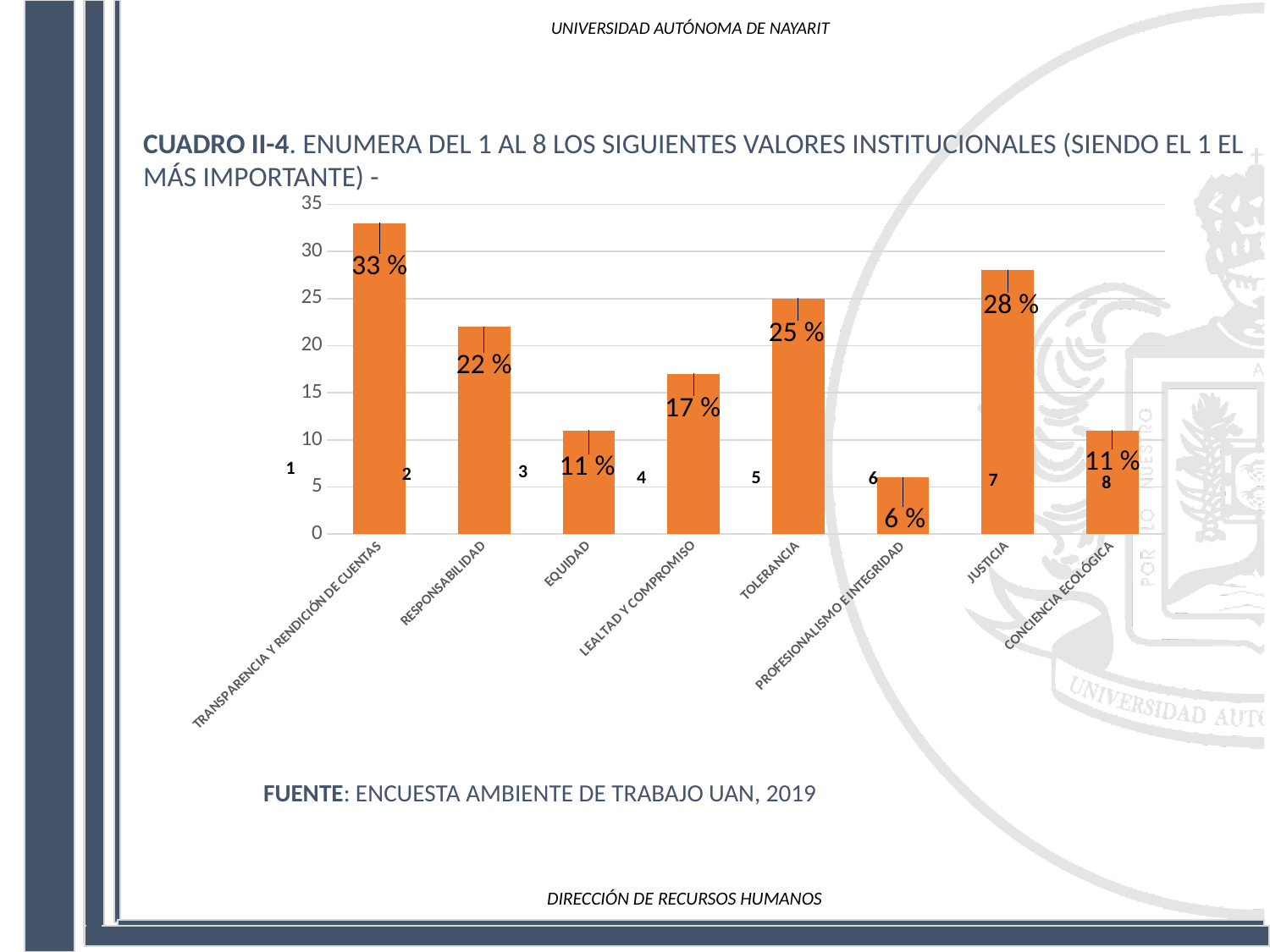
What is the value shown for RESPONSABILIDAD? 22 % What is the value shown for PROFESIONALISMO E INTEGRIDAD? 6 % What source is cited below the chart? ENCUESTA AMBIENTE DE TRABAJO UAN, 2019 Which category has the lowest value? PROFESIONALISMO E INTEGRIDAD Which is larger, the value for JUSTICIA or the value for TOLERANCIA? JUSTICIA Which category has the highest value? TRANSPARENCIA Y RENDICIÓN DE CUENTAS What is the value shown for TOLERANCIA? 25 % Is the value for EQUIDAD greater or less than 15? less What is the difference between the values for TRANSPARENCIA Y RENDICIÓN DE CUENTAS and JUSTICIA? 5 % How many categories are shown on the x axis? 8 What is the value shown for LEALTAD Y COMPROMISO? 17 % What kind of chart is shown on the slide? bar chart